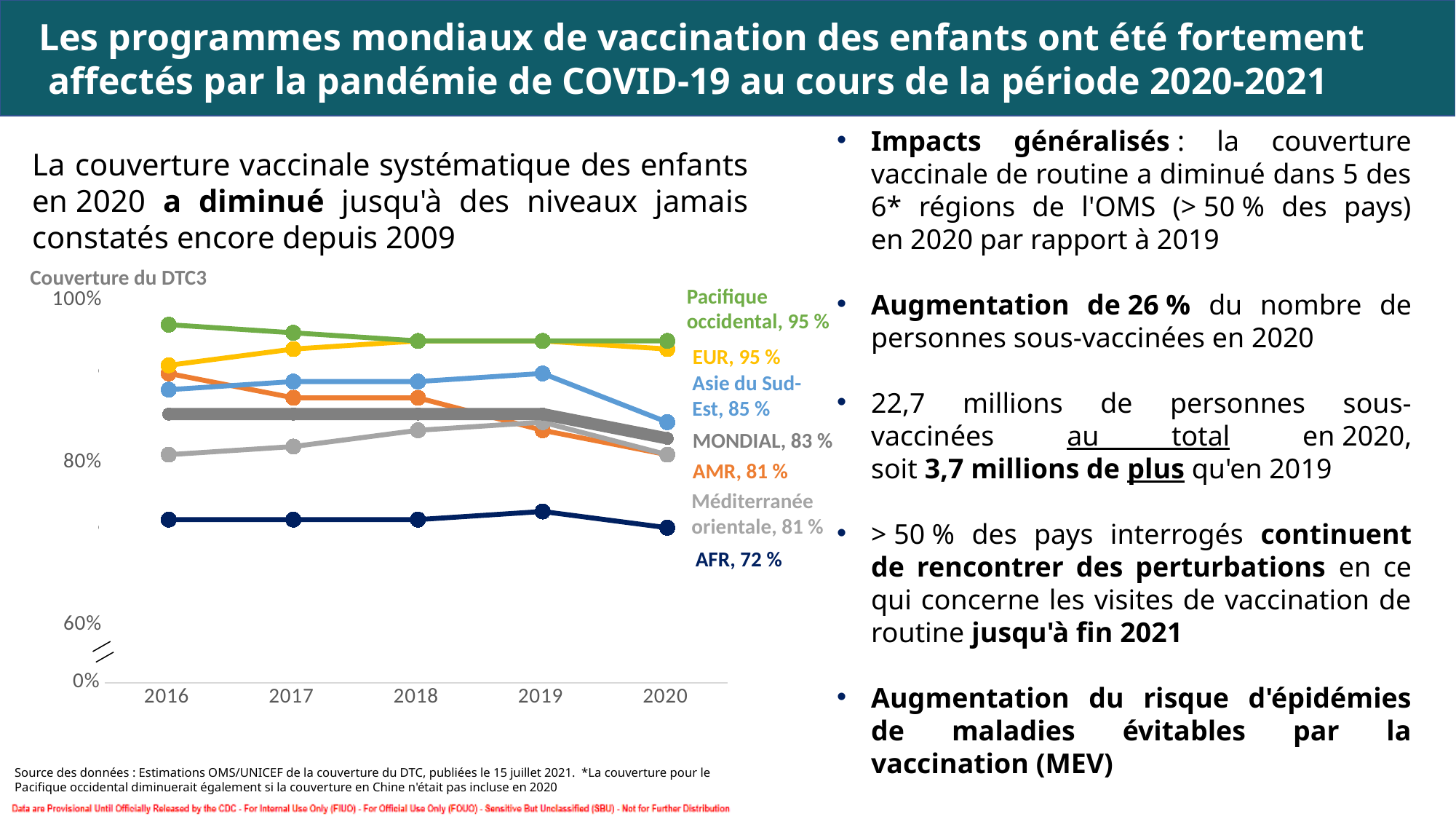
Is the value for AFR in 2016 greater or less than 80%? less What is the difference between the 2020 coverage of Pacifique occidental and AFR? 23 points de pourcentage How many years are plotted along the x axis of the chart? 5 What kind of chart is shown on the slide? line chart What is the DTC3 coverage for Asie du Sud-Est in 2020? 85 % Does the Asie du Sud-Est line rise or fall from 2019 to 2020? fall What is the DTC3 coverage for MONDIAL in 2020? 83 % What is the DTC3 coverage for AFR in 2020? 72 % In 2020, which has the higher coverage: Asie du Sud-Est or AMR? Asie du Sud-Est What is the title of the chart? Couverture du DTC3 How many series (regions) are plotted in the chart? 7 Which region has the lowest DTC3 coverage in 2020? AFR